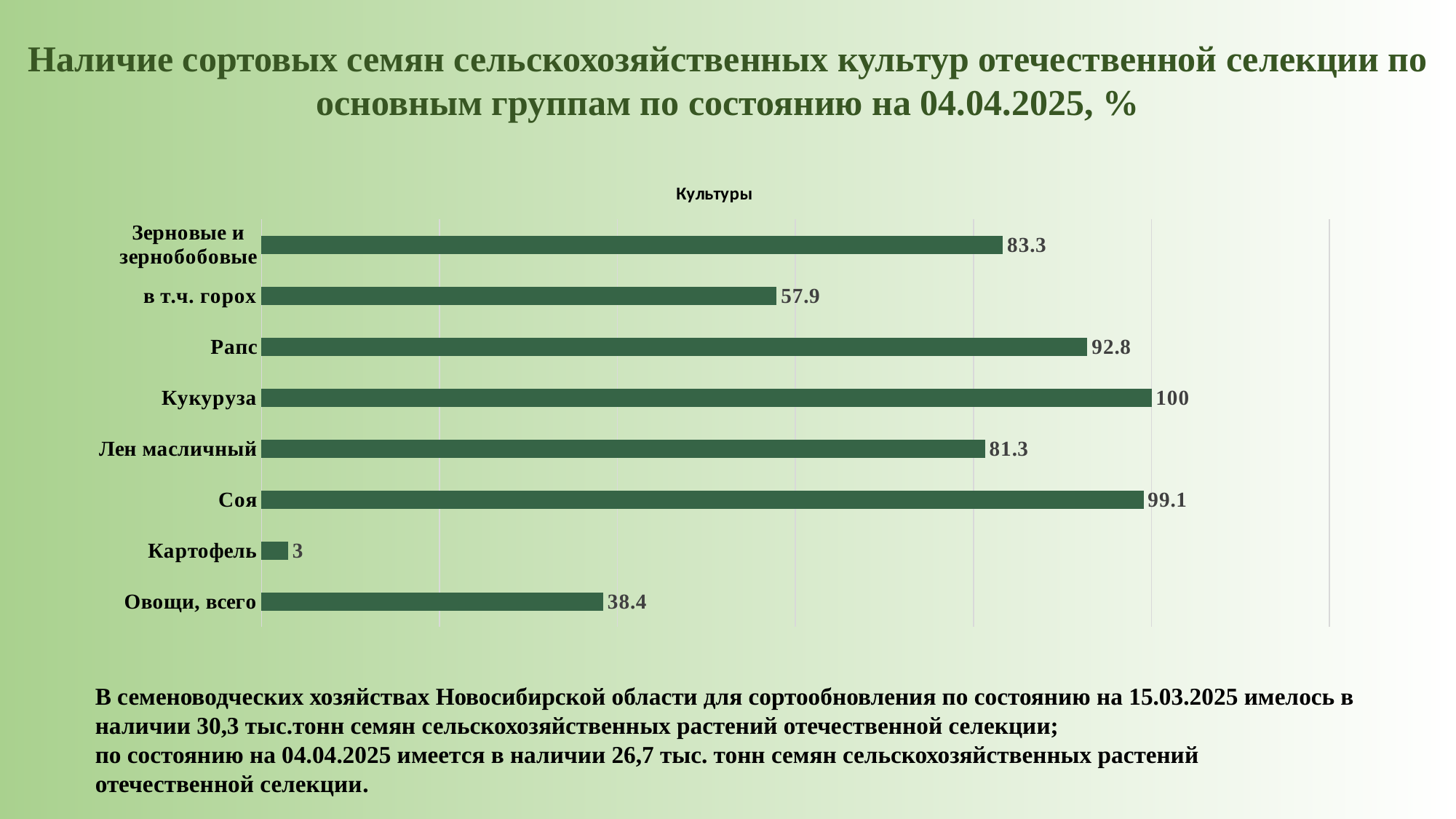
What is the value for Кукуруза? 100 What kind of chart is shown on the slide? Bar chart What is the value for Рапс? 92.8 What is the value for Картофель? 3 Which category has the highest value? Кукуруза What is the title shown above the chart's plot area? Культуры Which is larger, the value for Соя or the value for Лен масличный? Соя What is the difference between the values for Кукуруза and Соя? 0.9 How many categories are shown in the chart? 8 What is the value for Овощи, всего? 38.4 What is the difference between the values for Зерновые и зернобобовые and в т.ч. горох? 25.4 Which category has the lowest value? Картофель